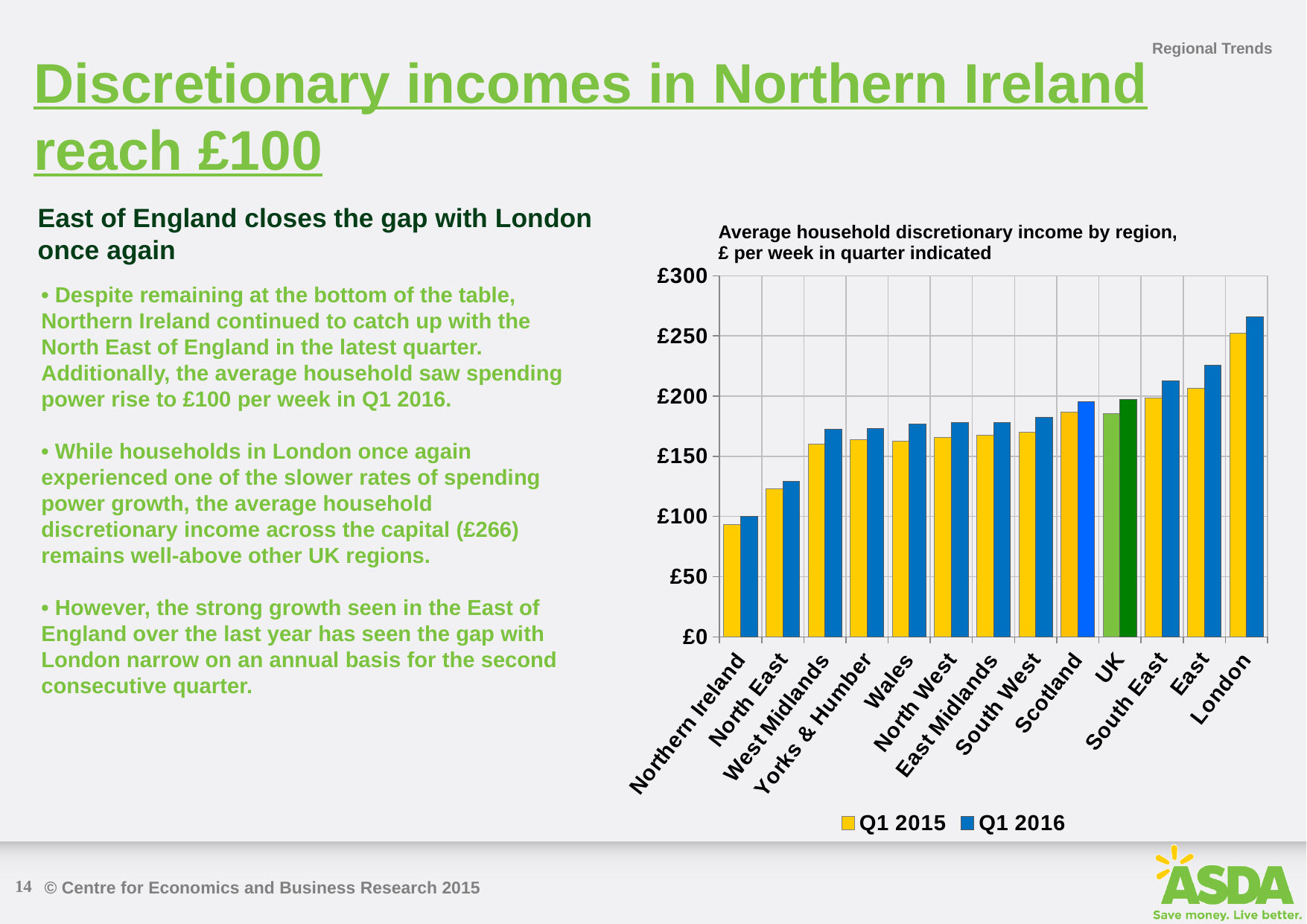
Which region has the highest average household discretionary income in Q1 2016? London How many series does the chart legend list? 2 Is the Q1 2016 value for London greater or less than £250? greater Which region has the lowest average household discretionary income in Q1 2016? Northern Ireland Which is larger in Q1 2016: the value for London or the value for East? London Is the Q1 2016 value for South East greater or less than £200? greater Is the Q1 2015 value for Northern Ireland greater or less than £100? less Do the Q1 2016 values generally rise or fall moving from left to right along the x axis? rise How many categories are shown along the x axis of the chart? 13 What kind of chart is shown on the slide? bar chart What is the Q1 2016 average household discretionary income for Northern Ireland? £100